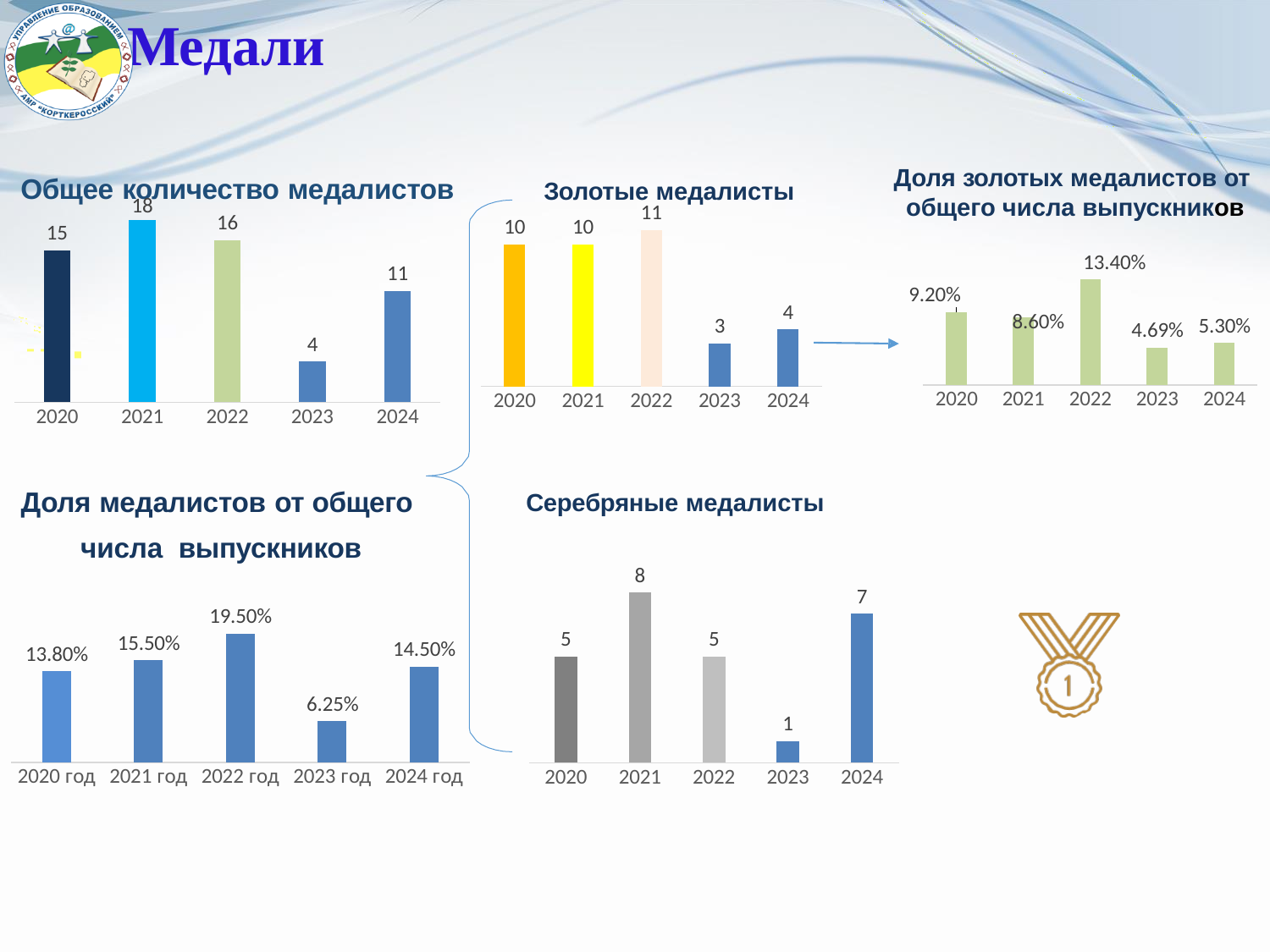
In the chart 'Доля медалистов от общего числа выпускников', which is larger, the value for 2021 год or 2024 год? 2021 год In the chart 'Золотые медалисты', what is the difference between the values for 2022 and 2023? 8 In the chart 'Серебряные медалисты', what is the value for 2024? 7 In the chart 'Золотые медалисты', what is the value for 2022? 11 In the chart 'Доля золотых медалистов от общего числа выпускников', which year has the highest value? 2022 In the chart 'Общее количество медалистов', what is the value for 2021? 18 In the chart 'Серебряные медалисты', which year has the highest value? 2021 What kind of chart is 'Общее количество медалистов'? bar chart How many years are shown in the chart 'Серебряные медалисты'? 5 In the chart 'Доля золотых медалистов от общего числа выпускников', what is the value for 2023? 4.69% In the chart 'Доля медалистов от общего числа выпускников', what is the value for 2022 год? 19.50% In the chart 'Общее количество медалистов', which year has the lowest value? 2023